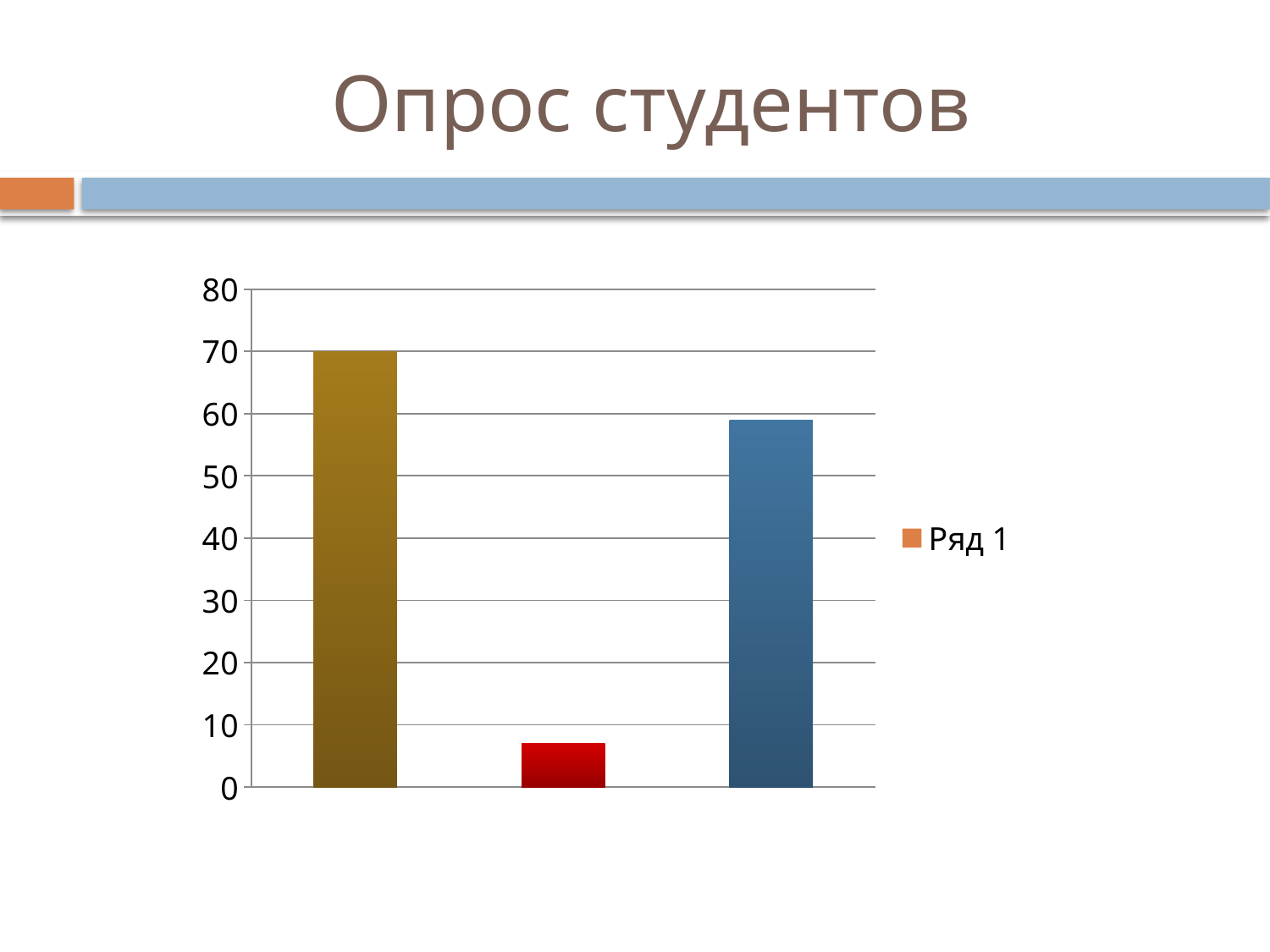
Is the value of the third (blue) bar greater or less than 50? greater What series name is shown in the legend? Ряд 1 Is the value of the second (red) bar greater or less than 10? less How many bars are plotted in the chart? 3 What is the value of the first (gold) bar? 70 How many series does the legend list? 1 What is the title of the slide? Опрос студентов Which bar is the highest? the first (gold) bar What kind of chart is shown on the slide? bar chart Which bar is the lowest? the second (red) bar Which is larger, the first (gold) bar or the third (blue) bar? the first (gold) bar